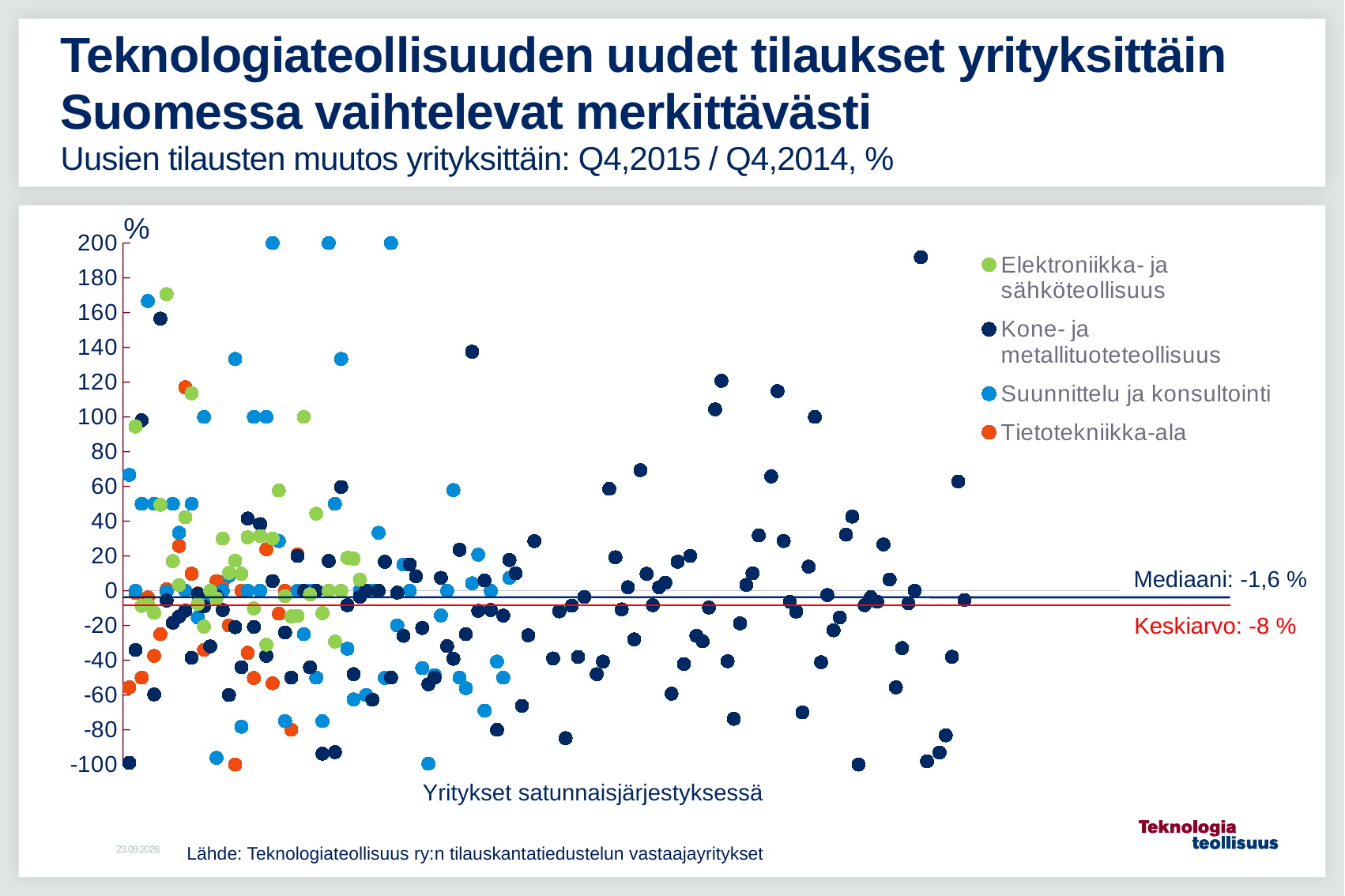
What is the difference between the median (-1,6 %) and the mean (-8 %)? 6,4 % What is the median (Mediaani) value shown on the chart? -1,6 % Is the mean (Keskiarvo) greater or less than 0? less Which legend entry is shown in green? Elektroniikka- ja sähköteollisuus What kind of chart is shown on the slide? scatter chart What unit is shown on the y axis? % Which is larger, the median (Mediaani) or the mean (Keskiarvo)? Mediaani What is the mean (Keskiarvo) value shown on the chart? -8 % What is the highest value on the y axis? 200 Which series is shown in orange? Tietotekniikka-ala What is the label of the x axis? Yritykset satunnaisjärjestyksessä How many series does the legend list? 4